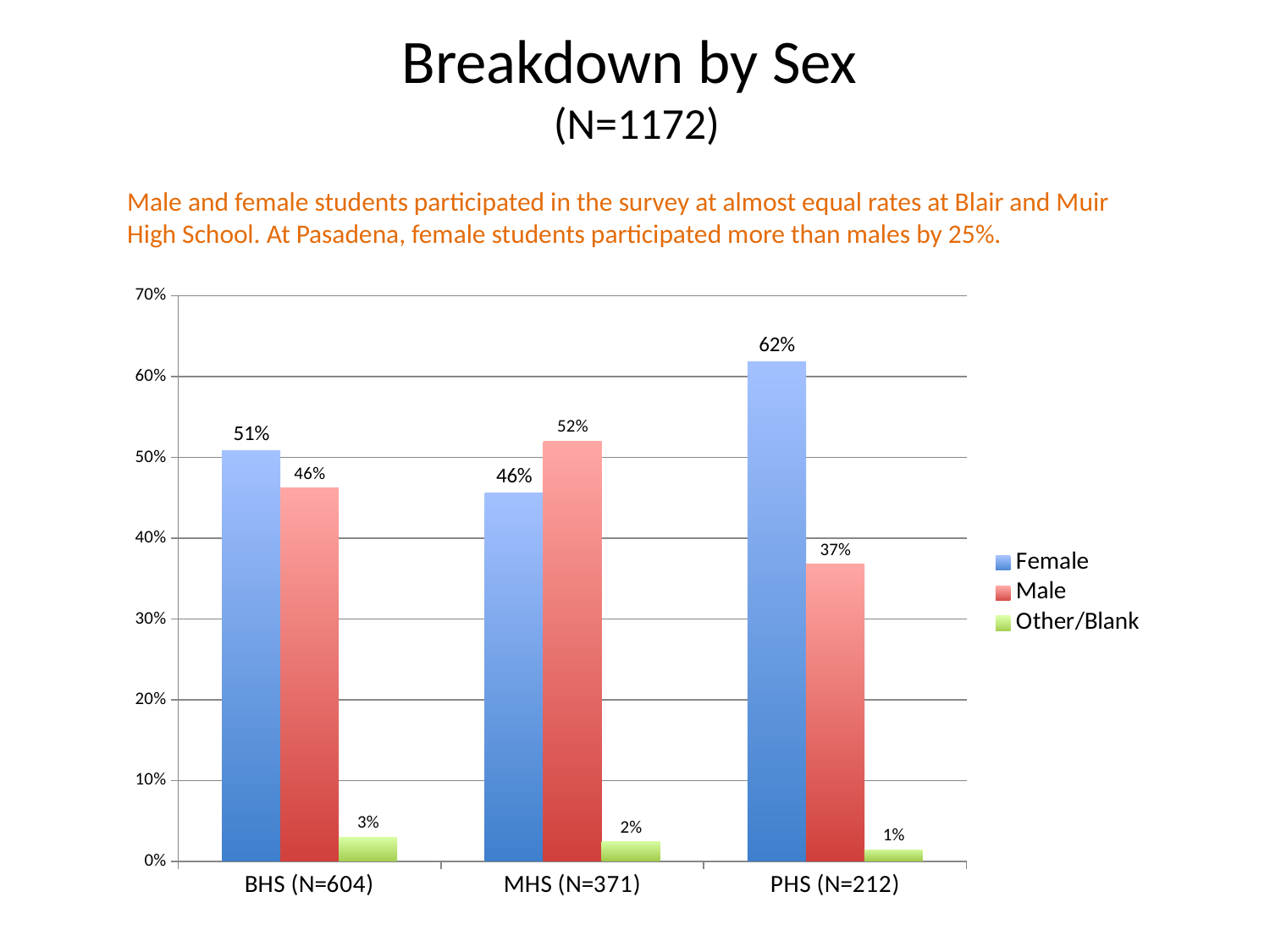
Which school has the lowest Male value? PHS (N=212) What is the difference between the Female and Male values for PHS (N=212)? 25% Which is larger for MHS (N=371), the Female value or the Male value? Male What is the Female value for PHS (N=212)? 62% How many series does the legend list? 3 What is the Male value for MHS (N=371)? 52% Which school has the highest Female value? PHS (N=212) Which colour represents the Male series in the legend? Red What is the Other/Blank value for BHS (N=604)? 3% Does the Other/Blank value rise or fall from BHS to PHS along the x axis? Fall How many schools (categories) are shown on the x axis? 3 What kind of chart is shown on the slide? Bar chart